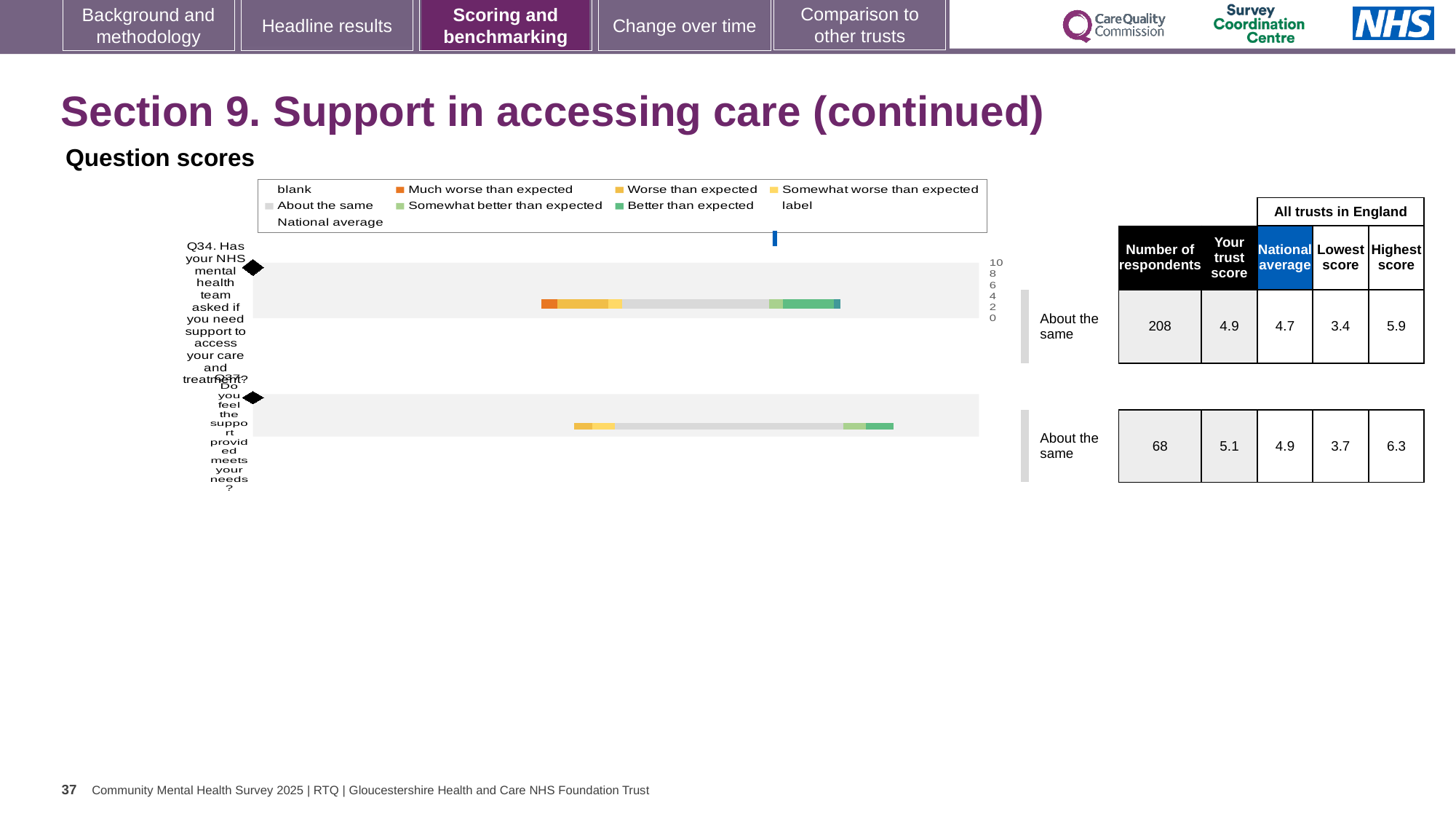
What is the heading above the chart? Question scores Which question has the higher 'Highest score' in the table? Q37 What kind of chart is used to show the question scores on this slide? bar chart What colour does the legend use for 'Much worse than expected'? orange Which question has the higher 'Your trust score' in the table, Q34 or Q37? Q37 In the table beside the chart, what is the 'Your trust score' for Q34? 4.9 How many entries does the chart legend list? 9 In the table, what is the difference between the highest score and the lowest score for Q37? 2.6 How many questions are plotted as bars in the chart? 2 What benchmark category is shown next to the Q34 bar? About the same In the table beside the chart, how many respondents answered Q34? 208 In the table beside the chart, what is the national average for Q37? 4.9